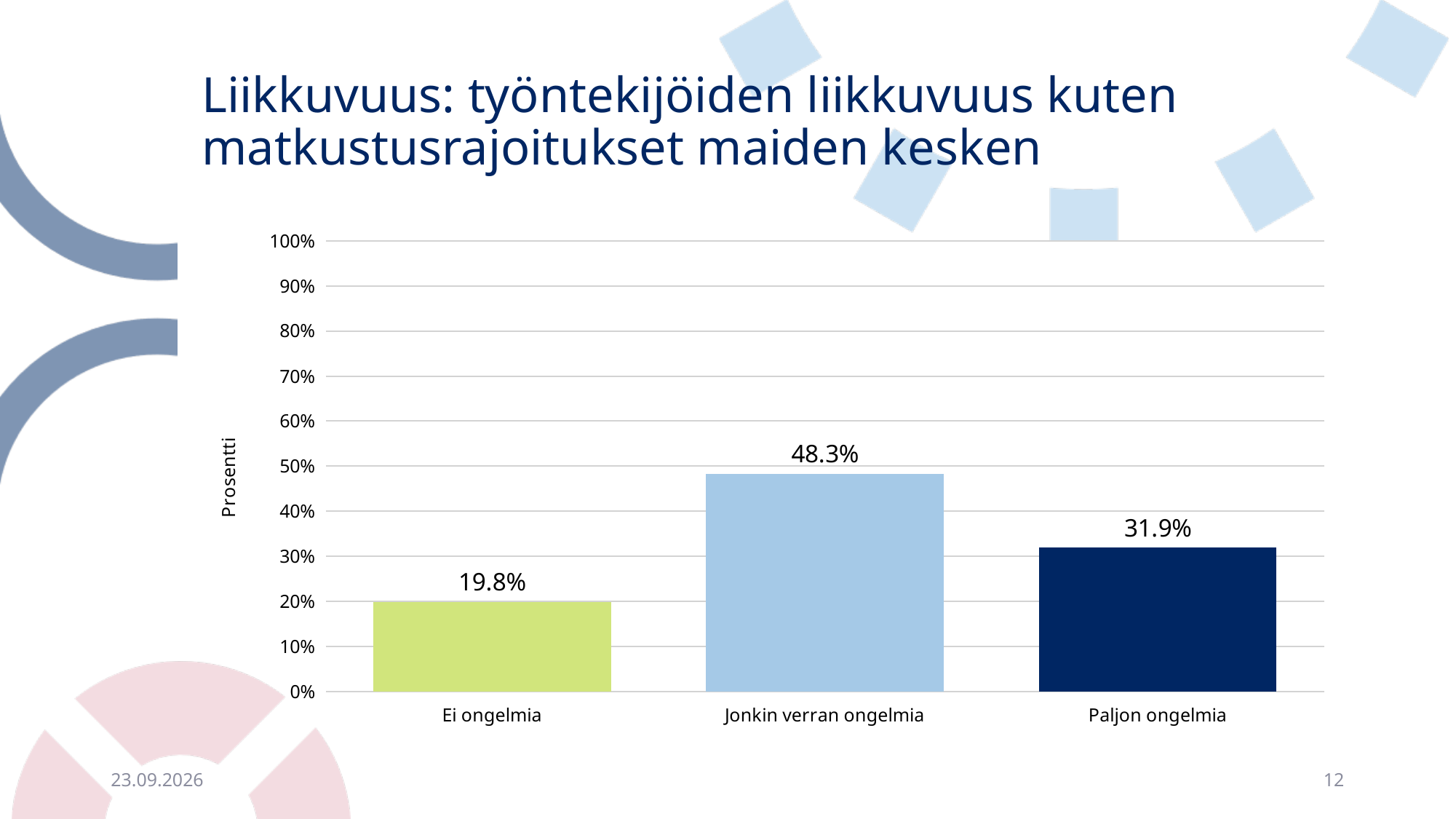
What kind of chart is shown on the slide? bar chart What is the label of the vertical axis? Prosentti What is the value for "Jonkin verran ongelmia"? 48.3% Is the value for "Jonkin verran ongelmia" greater or less than 50%? less What is the difference between the values for "Paljon ongelmia" and "Ei ongelmia"? 12.1% Which category has the lowest value? Ei ongelmia How many categories are shown on the x axis? 3 What is the difference between the values for "Jonkin verran ongelmia" and "Paljon ongelmia"? 16.4% What is the value for "Paljon ongelmia"? 31.9% Which category has the highest value? Jonkin verran ongelmia Which is larger, the value for "Paljon ongelmia" or the value for "Ei ongelmia"? Paljon ongelmia What is the value for "Ei ongelmia"? 19.8%